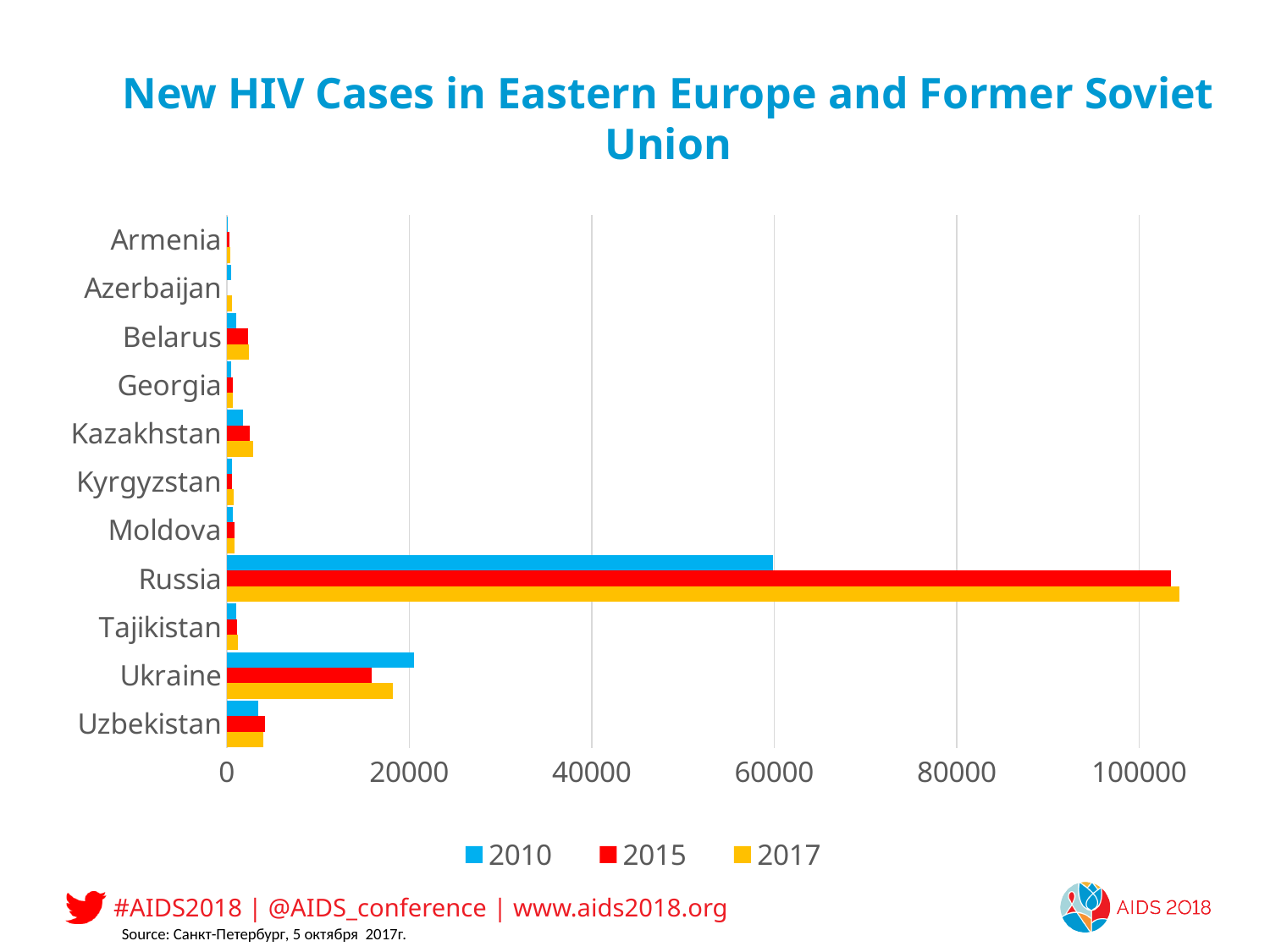
Which country has the highest number of new HIV cases in 2017? Russia What kind of chart is shown on the slide? bar chart How many countries are listed on the chart? 11 Is the 2017 value for Uzbekistan greater or less than 20000? less Which country has the larger 2017 value: Ukraine or Uzbekistan? Ukraine Do the values for Russia rise or fall from 2010 to 2017? rise Which is larger for Ukraine: the 2010 value or the 2015 value? 2010 Is the 2015 value for Ukraine greater or less than 20000? less Is the 2015 value for Russia greater or less than 100000? greater What is the title of the chart? New HIV Cases in Eastern Europe and Former Soviet Union How many series does the legend list? 3 Which colour represents the 2015 series in the legend? red